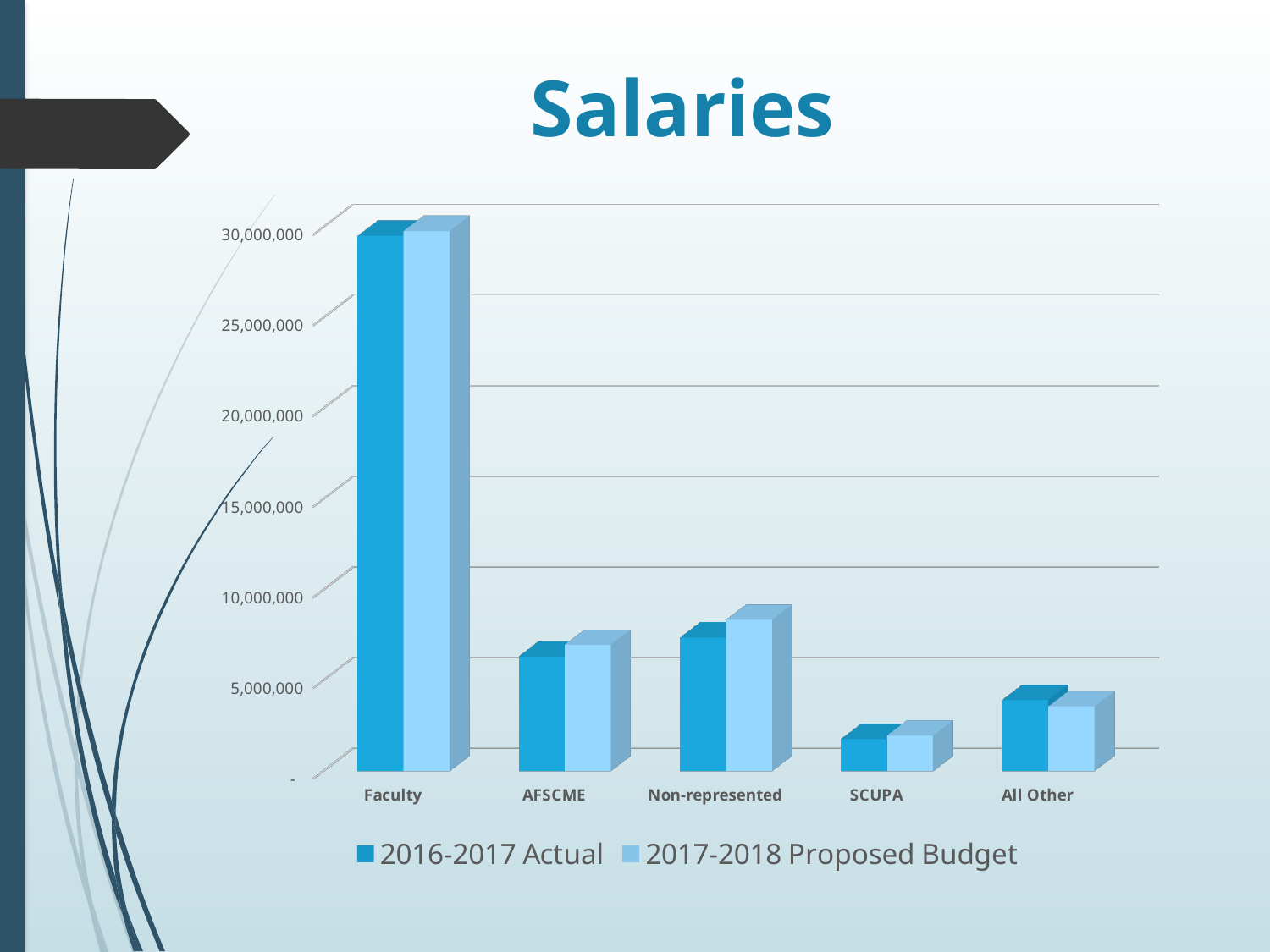
Which category has larger 2016-2017 Actual salaries, AFSCME or All Other? AFSCME What kind of chart is shown on the slide? bar chart Is the 2016-2017 Actual value for Faculty greater or less than 25,000,000? greater Which is larger for Non-represented: the 2016-2017 Actual or the 2017-2018 Proposed Budget? 2017-2018 Proposed Budget What are the two series named in the legend? 2016-2017 Actual and 2017-2018 Proposed Budget How many series does the legend list? 2 What is the title of the chart? Salaries Is the 2016-2017 Actual value for SCUPA greater or less than 5,000,000? less Is the 2017-2018 Proposed Budget value for Non-represented greater or less than 10,000,000? less How many categories are shown on the x axis? 5 Which category has the highest 2016-2017 Actual salaries? Faculty Which category has the lowest 2017-2018 Proposed Budget salaries? SCUPA